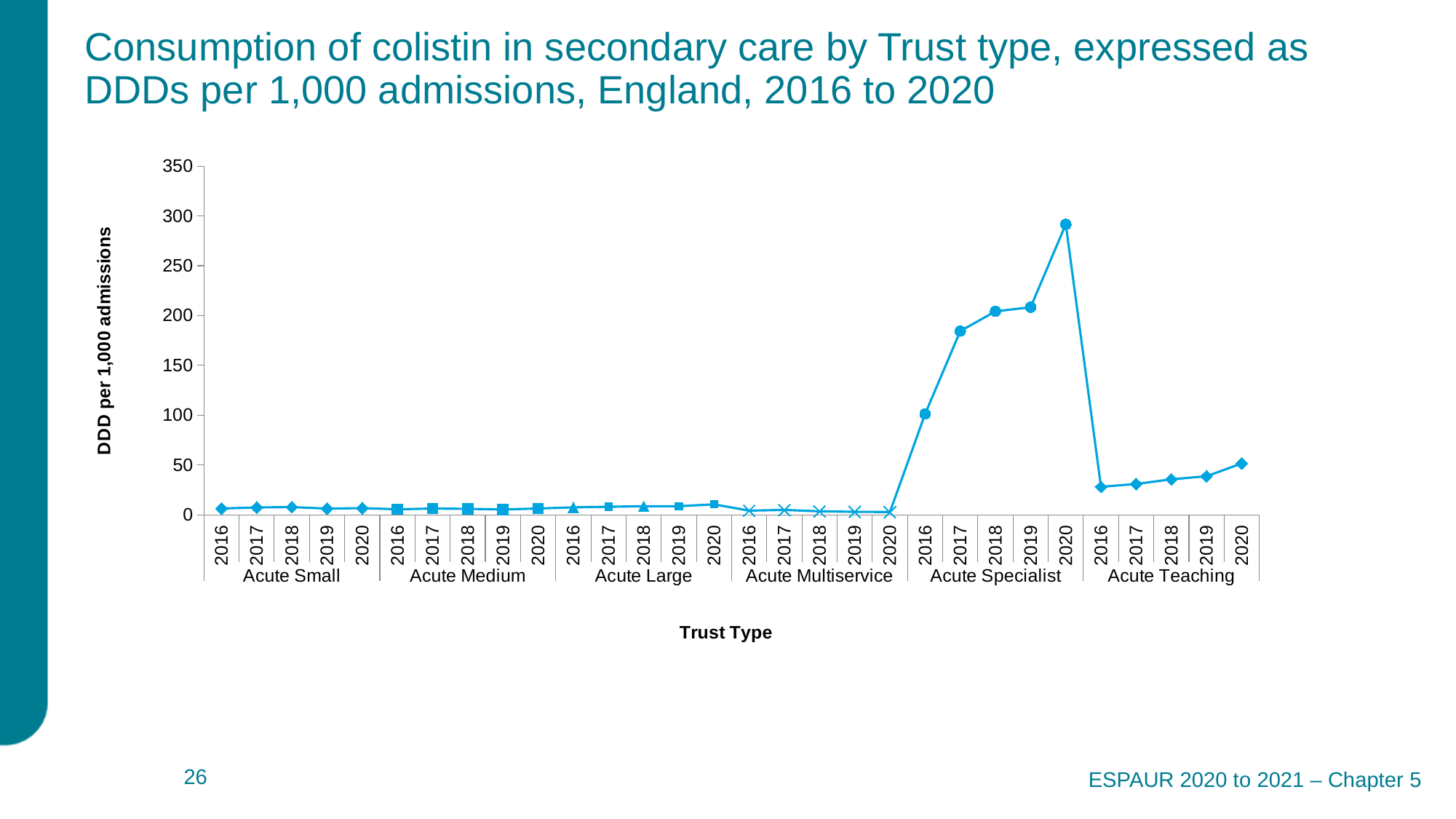
Which trust type and year has the highest DDD per 1,000 admissions? Acute Specialist, 2020 How many trust types are shown on the x axis? 6 Which is larger, the value for Acute Specialist in 2017 or the value for Acute Teaching in 2017? Acute Specialist in 2017 What kind of chart is shown on the slide? line chart Is the value for Acute Specialist in 2017 greater or less than 150? greater Is the value for Acute Specialist in 2020 greater or less than 250? greater How many years are plotted for each trust type? 5 Is the value for Acute Teaching in 2016 greater or less than 50? less What is the title of the y axis? DDD per 1,000 admissions Which trust type has the lowest colistin consumption across all years? Acute Multiservice Do the values for Acute Teaching rise or fall from 2016 to 2020? rise